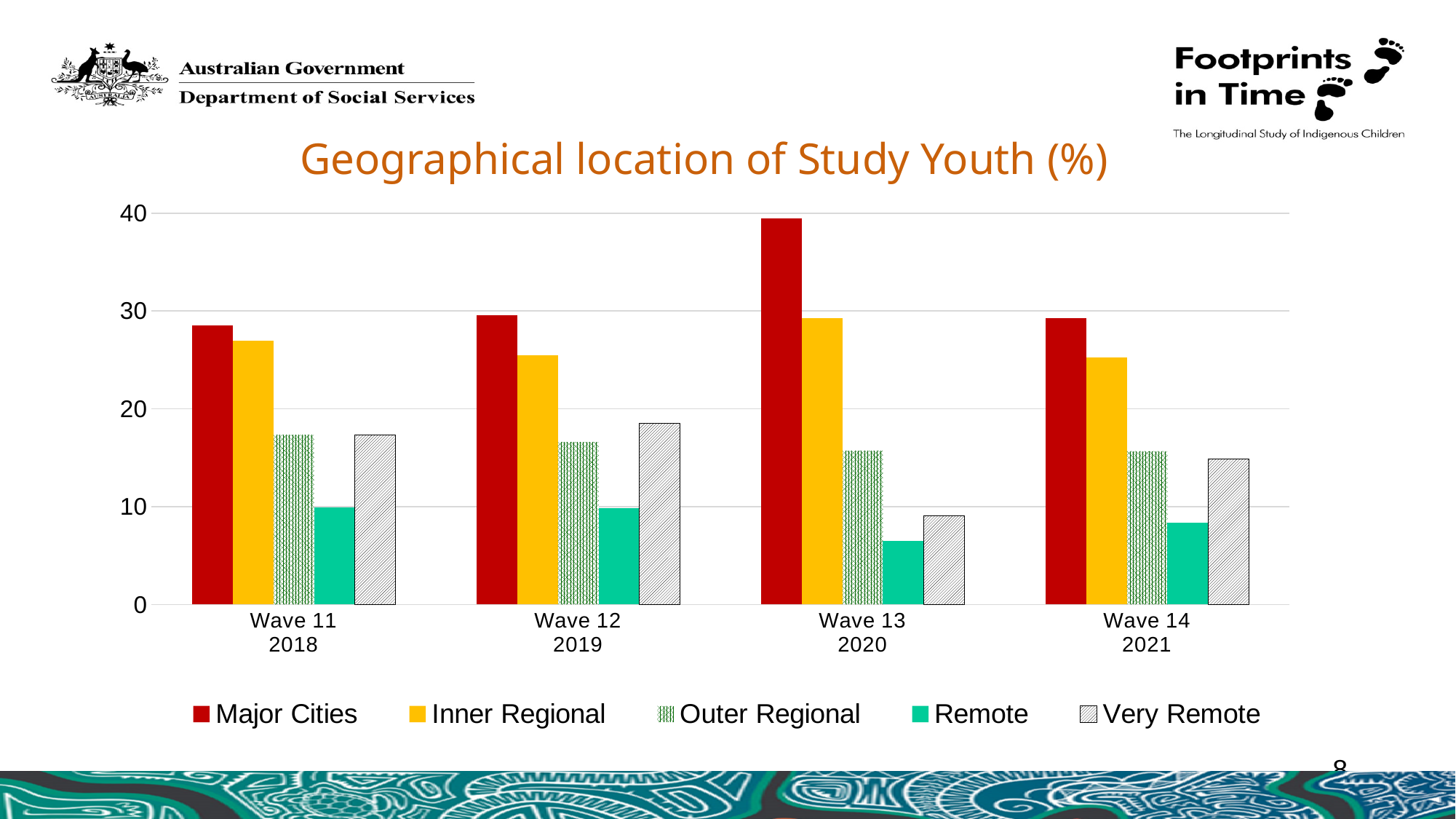
Is the Very Remote value for Wave 14 2021 greater or less than 10? greater In which wave is the Remote value lowest? Wave 13 2020 Is the Remote value for Wave 11 2018 greater or less than 20? less What colour represents Major Cities in the legend? Red How many series does the legend list? 5 In which wave is the Major Cities value highest? Wave 13 2020 Does the Remote value rise or fall from Wave 11 2018 to Wave 13 2020? Fall Which series has the lowest value in Wave 14 2021? Remote How many waves are shown on the x axis? 4 What kind of chart is shown on the slide? Bar chart In Wave 12 2019, which is larger: Very Remote or Outer Regional? Very Remote Is the Major Cities value for Wave 13 2020 greater or less than 30? greater